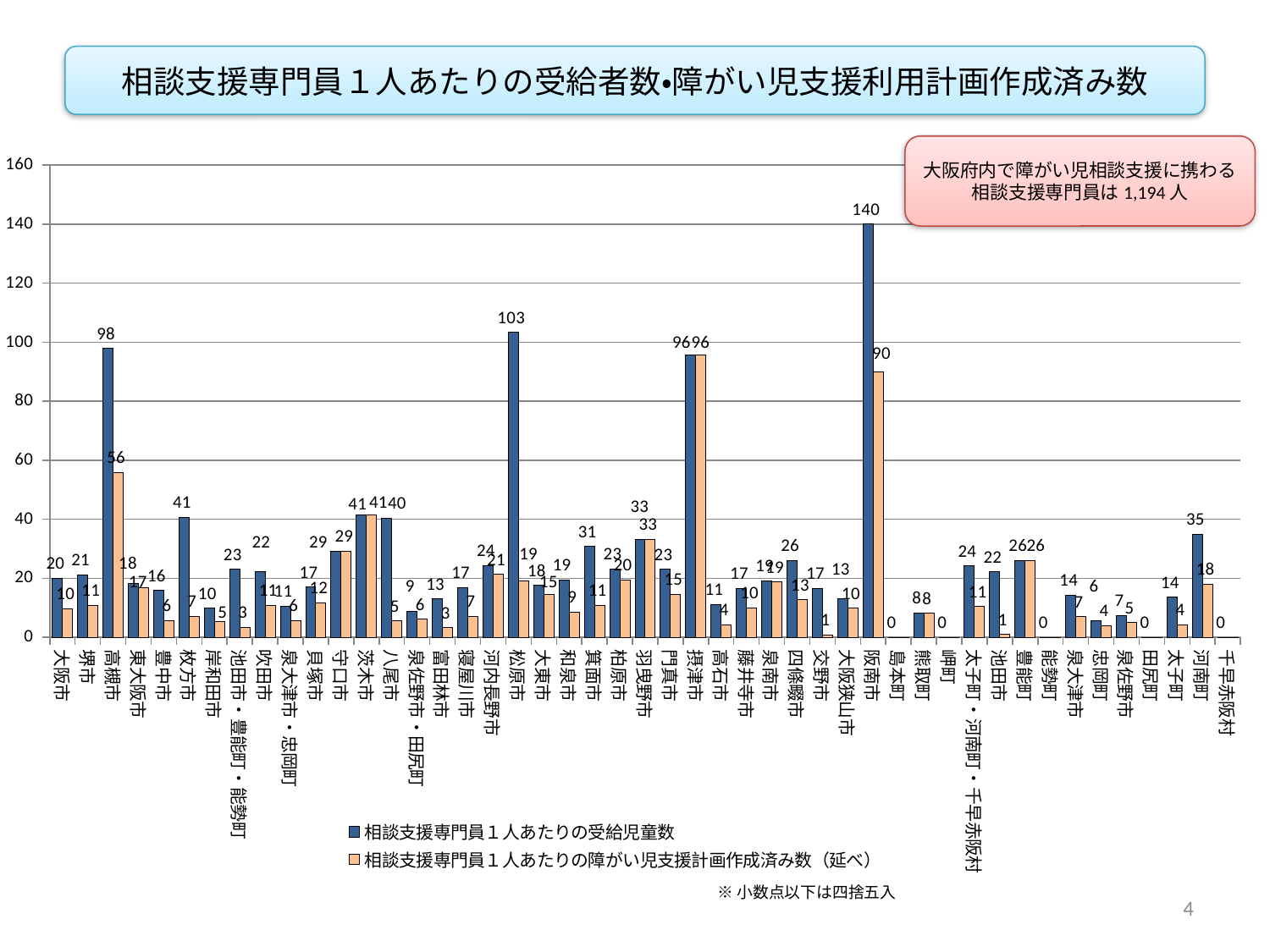
Which municipality has the highest value for 相談支援専門員１人あたりの受給児童数? 阪南市 What is the value of 相談支援専門員１人あたりの受給児童数 for 河南町? 35 Which municipality has the highest value for 相談支援専門員１人あたりの障がい児支援計画作成済み数（延べ）? 摂津市 What is the title of the chart? 相談支援専門員１人あたりの受給者数•障がい児支援利用計画作成済み数 Which is larger: the 相談支援専門員１人あたりの受給児童数 value for 松原市 or for 高槻市? 松原市 Is the value of 相談支援専門員１人あたりの受給児童数 for 阪南市 greater or less than 120? greater How many series does the legend list? 2 What is the difference between the two series for 松原市? 84 What type of chart is shown on the slide? bar chart What is the value of 相談支援専門員１人あたりの障がい児支援計画作成済み数（延べ） for 交野市? 1 What is the value of 相談支援専門員１人あたりの受給児童数 for 高槻市? 98 What is the value of 相談支援専門員１人あたりの障がい児支援計画作成済み数（延べ） for 阪南市? 90